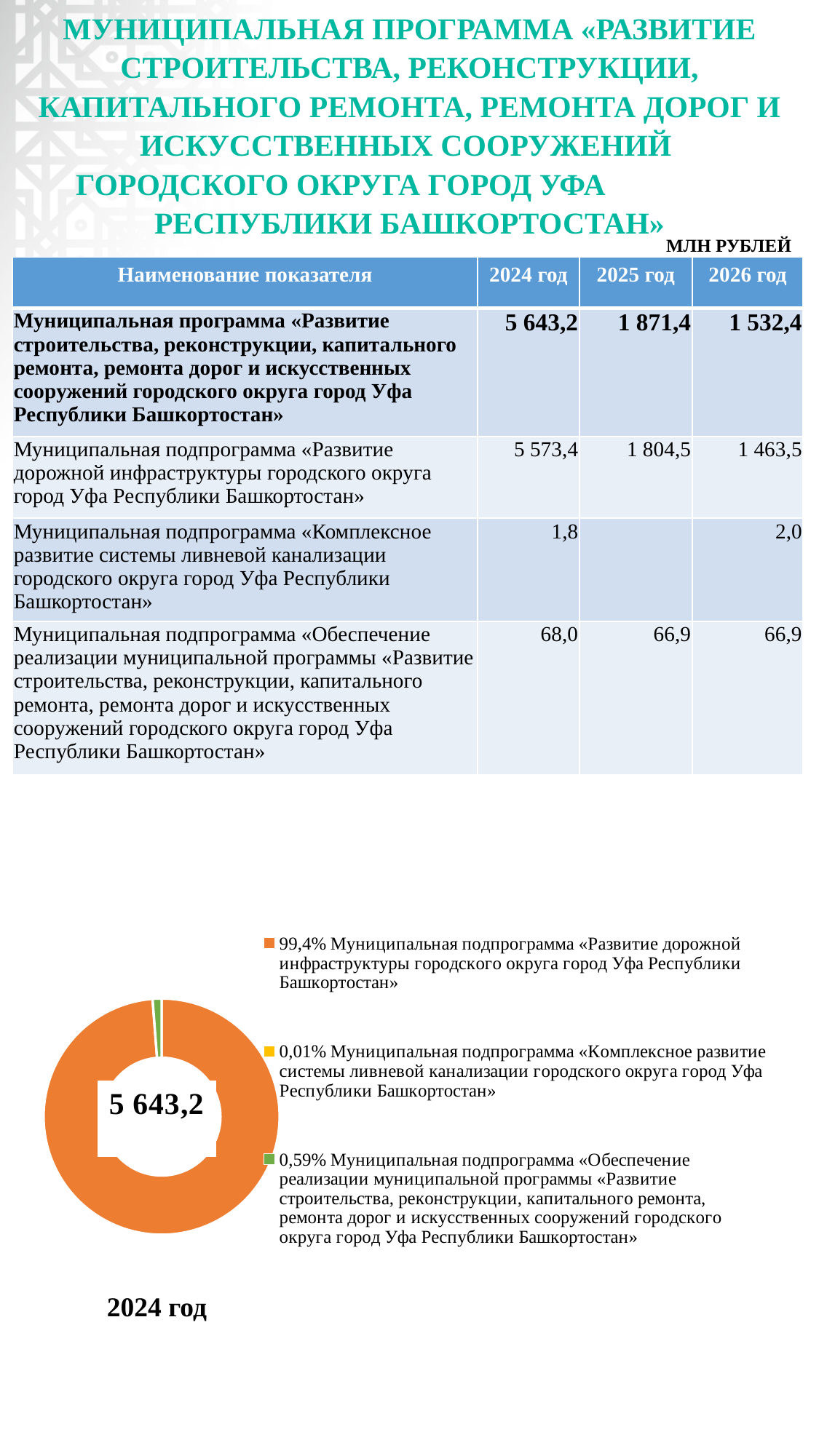
What colour is the slice for «Развитие дорожной инфраструктуры» in the pie chart? Orange In the pie chart, which slice is larger: «Обеспечение реализации муниципальной программы» or «Комплексное развитие системы ливневой канализации»? «Обеспечение реализации муниципальной программы» What share of the pie chart does the subprogramme «Обеспечение реализации муниципальной программы ...» have? 0,59% What share of the pie chart does the subprogramme «Комплексное развитие системы ливневой канализации городского округа город Уфа Республики Башкортостан» have? 0,01% What kind of chart is shown at the bottom of the slide? Pie (donut) chart Which year does the pie chart represent? 2024 год Which subprogramme has the largest slice in the pie chart? Муниципальная подпрограмма «Развитие дорожной инфраструктуры городского округа город Уфа Республики Башкортостан» What is the difference in share between the «Обеспечение реализации» slice (0,59%) and the «Комплексное развитие системы ливневой канализации» slice (0,01%)? 0,58% What value is printed in the centre of the donut chart? 5 643,2 How many slices does the pie chart for 2024 год have? 3 What share of the pie chart does the subprogramme «Развитие дорожной инфраструктуры городского округа город Уфа Республики Башкортостан» have? 99,4% Which subprogramme has the smallest slice in the pie chart? Муниципальная подпрограмма «Комплексное развитие системы ливневой канализации городского округа город Уфа Республики Башкортостан»